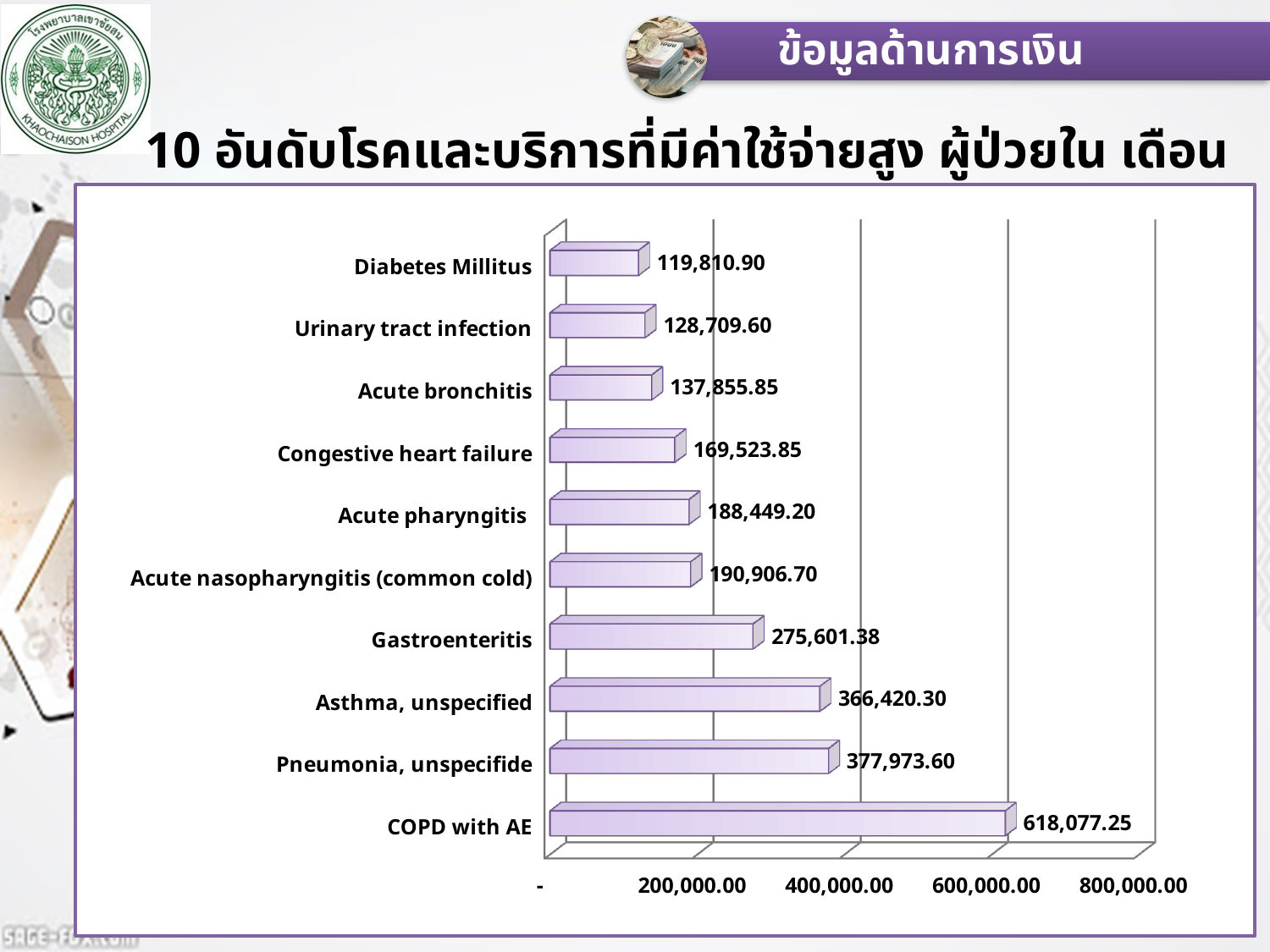
What is the difference between the values for COPD with AE and Pneumonia, unspecifide? 240,103.65 Is the value for COPD with AE greater or less than 600,000.00? greater How many categories are shown in the chart? 10 Which category has the highest value? COPD with AE What is the value for Gastroenteritis? 275,601.38 Which category has the lowest value? Diabetes Millitus What is the value for Acute nasopharyngitis (common cold)? 190,906.70 What is the value for COPD with AE? 618,077.25 What is the value for Diabetes Millitus? 119,810.90 Which is larger, the value for Pneumonia, unspecifide or the value for Asthma, unspecified? Pneumonia, unspecifide What is the difference between the values for Asthma, unspecified and Gastroenteritis? 90,818.92 What kind of chart is shown on the slide? bar chart